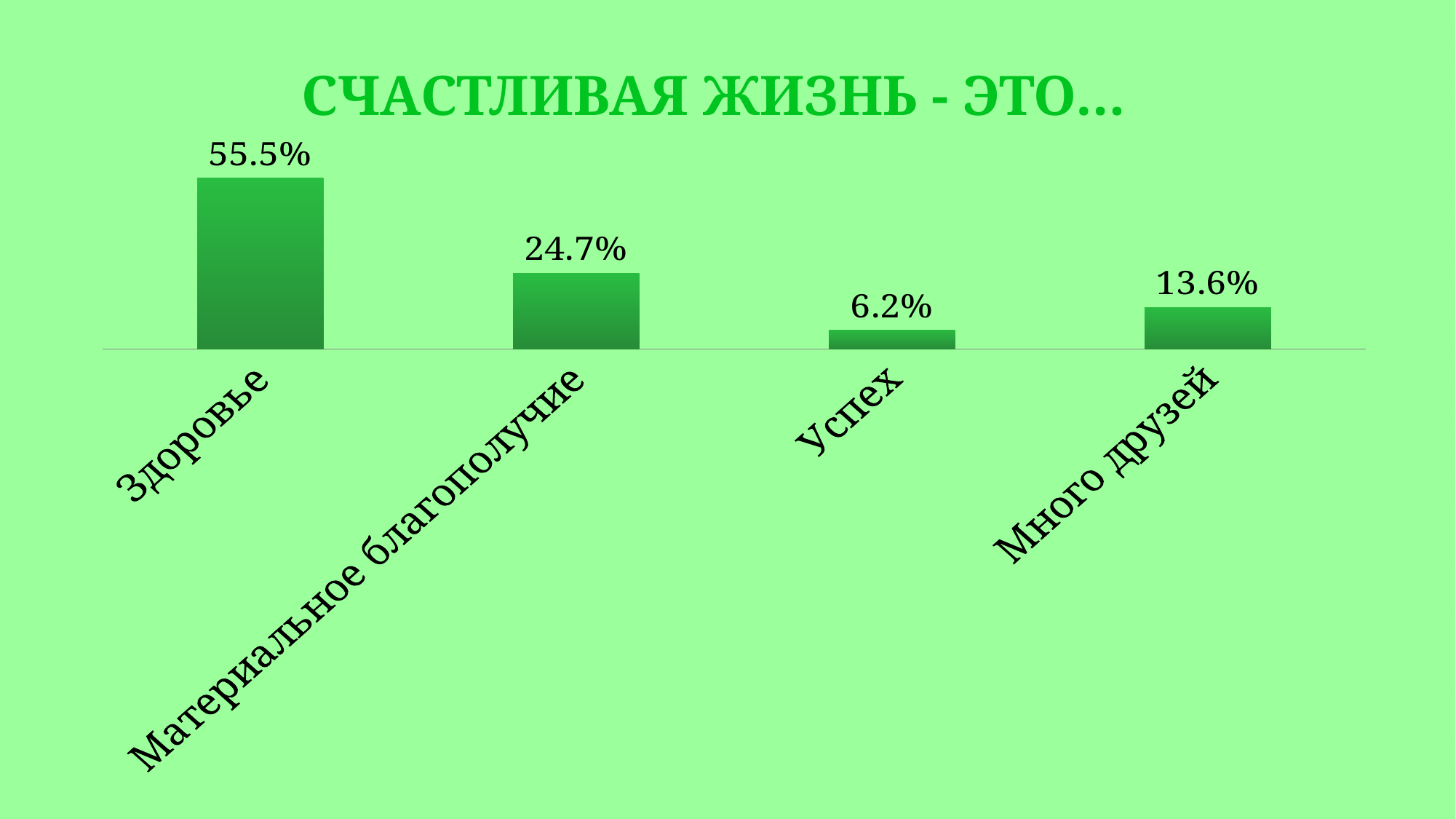
What is the value for Здоровье? 55.5% What is the value for Много друзей? 13.6% Which category has the highest value? Здоровье Which is larger, the value for Материальное благополучие or the value for Много друзей? Материальное благополучие Which category has the lowest value? Успех What is the value for Успех? 6.2% How many categories are shown in the chart? 4 What kind of chart is shown on the slide? Bar chart What is the title of the chart? СЧАСТЛИВАЯ ЖИЗНЬ - ЭТО… What is the difference between the values for Здоровье and Материальное благополучие? 30.8% What is the difference between the values for Много друзей and Успех? 7.4% What is the value for Материальное благополучие? 24.7%